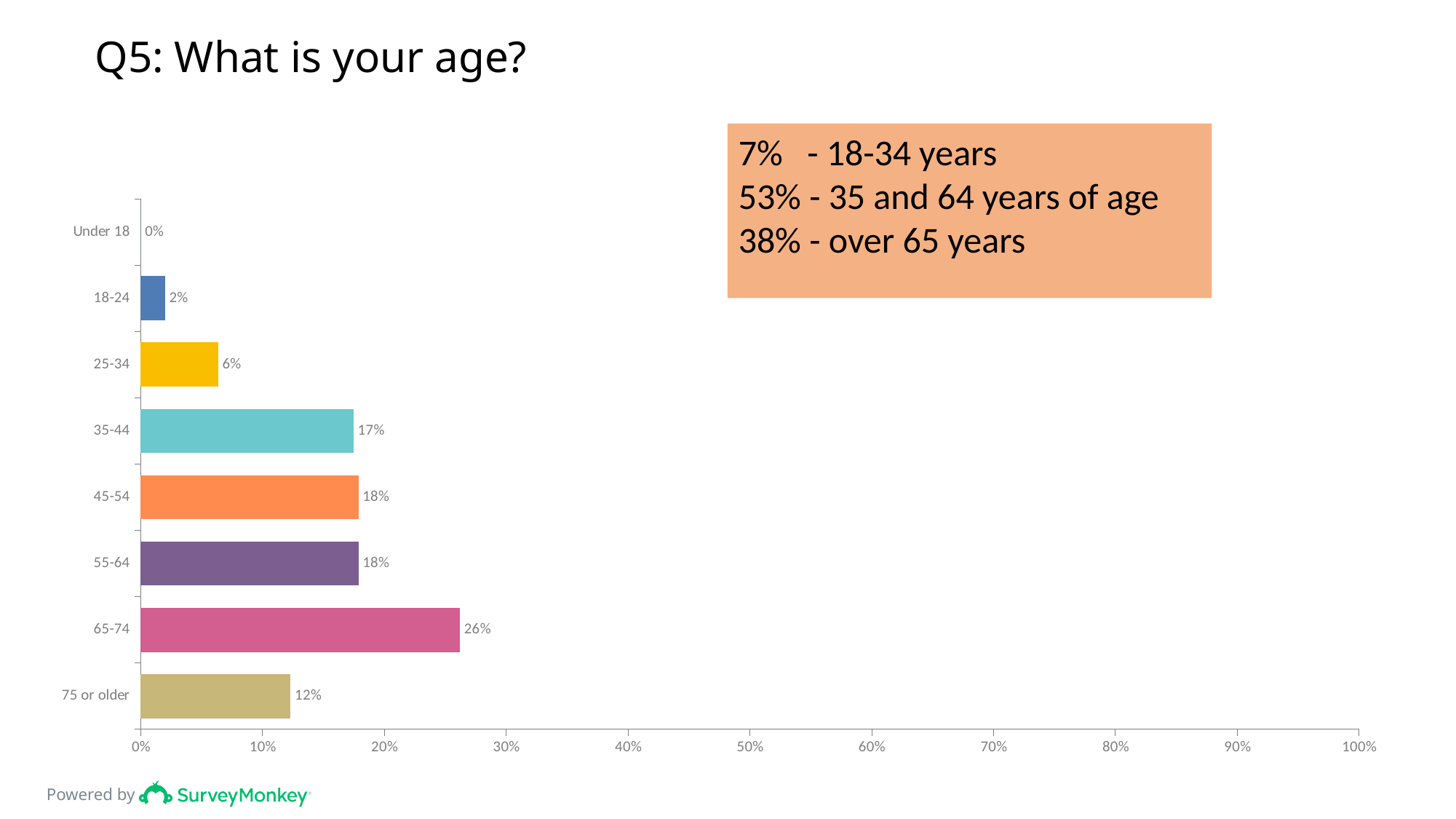
Which age group has the highest percentage? 65-74 Is the value for 65-74 greater or less than 20%? greater How many age categories are shown on the chart? 8 What is the title of the chart? Q5: What is your age? What kind of chart is shown on the slide? bar chart What is the highest value shown on the horizontal axis? 100% What percentage of respondents are aged 65-74? 26% Which age group has the lowest percentage? Under 18 What is the value shown for the 35-44 age group? 17% Which is larger, the value for 25-34 or the value for 18-24? 25-34 What is the difference between the 65-74 and 75 or older percentages? 14% What percentage of respondents are 75 or older? 12%